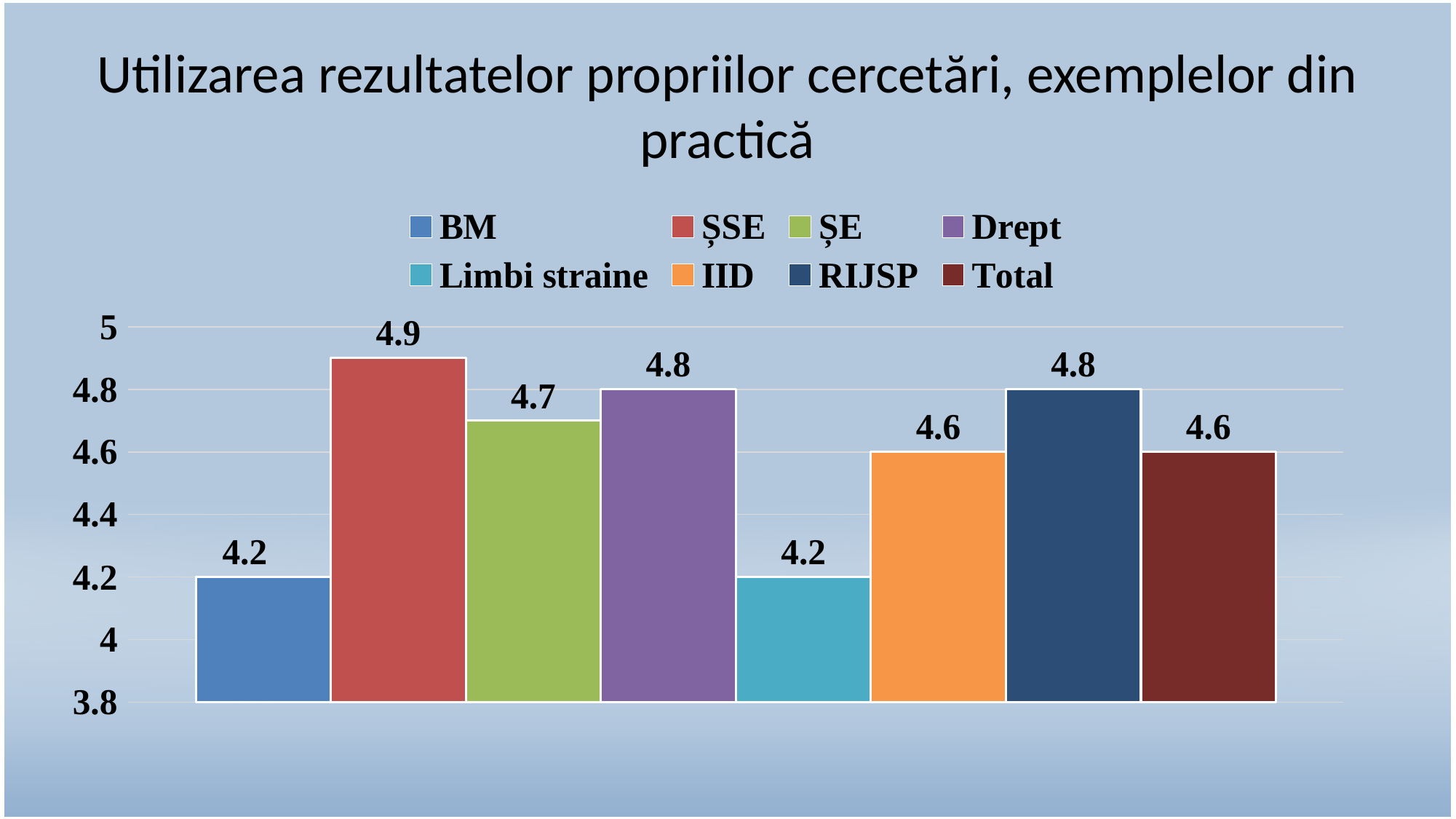
Which series has the highest value? ȘSE What is the difference between the values for Drept and Total? 0.2 What is the value for Total? 4.6 How many series does the legend list? 8 Which is larger, the value for IID or the value for Drept? Drept What is the value for ȘSE? 4.9 What kind of chart is shown on the slide? bar chart Is the value for RIJSP greater or less than 4.6? greater What is the value for Limbi straine? 4.2 What is the difference between the values for ȘSE and BM? 0.7 What is the title of the chart? Utilizarea rezultatelor propriilor cercetări, exemplelor din practică What is the value for ȘE? 4.7